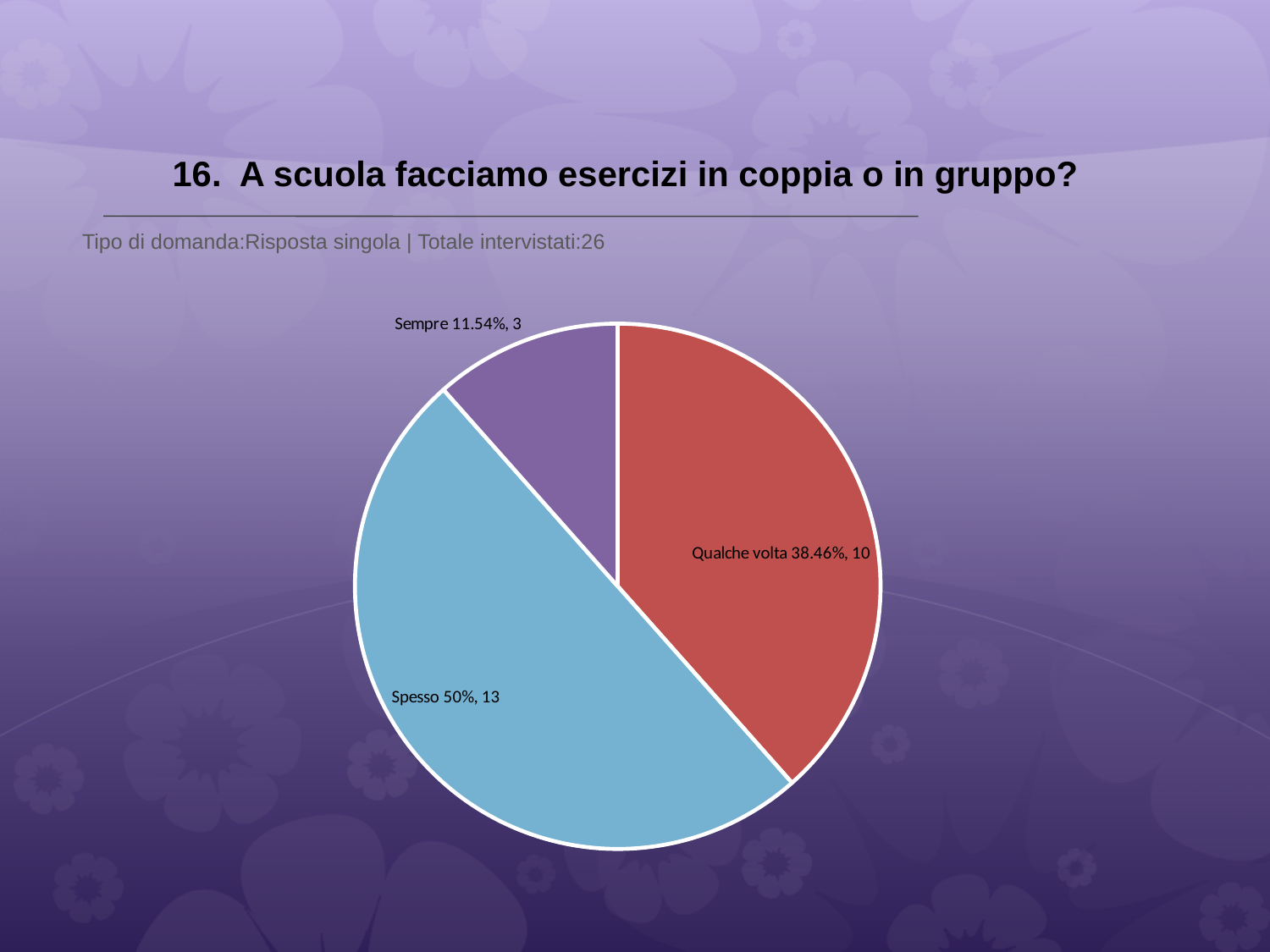
How many slices does the pie chart have? 3 What percentage is shown for 'Qualche volta'? 38.46% What is the count for the 'Spesso' slice? 13 What share of the pie does 'Sempre' represent? 11.54% Which is larger, the count for 'Qualche volta' or the count for 'Sempre'? Qualche volta What colour is the 'Spesso' slice? blue What share of the pie does 'Spesso' represent? 50% Which category has the largest slice? Spesso What kind of chart is shown on the slide? pie chart What is the difference in count between 'Spesso' and 'Qualche volta'? 3 Which category has the smallest slice? Sempre What is the count for the 'Sempre' slice? 3